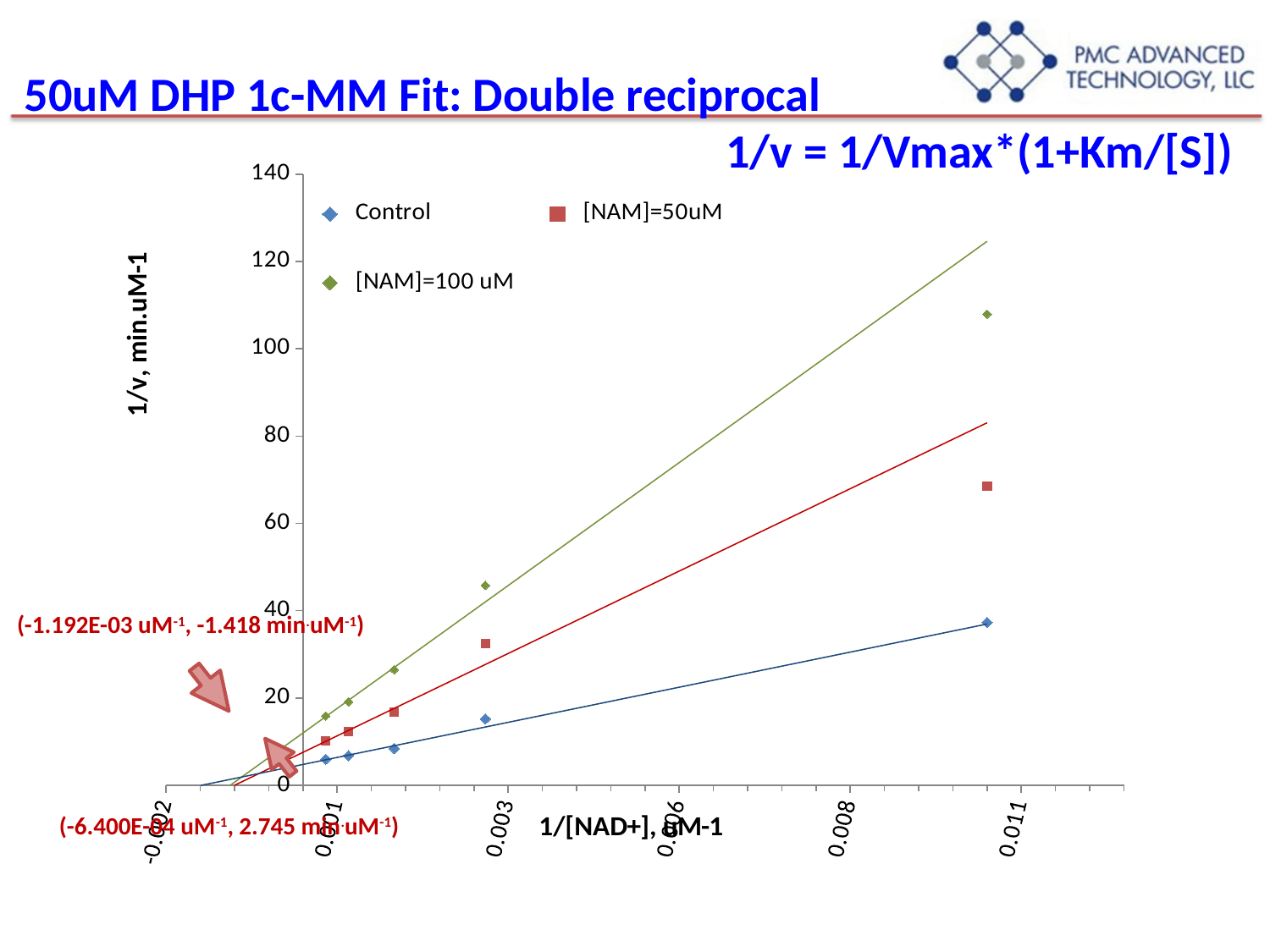
Which series has the lowest 1/v value at the largest 1/[NAD+] value (around 0.0105)? Control How many data points are plotted for the Control series? 5 What is the title of the y axis? 1/v, min.uM-1 At the rightmost data point, which series has the larger 1/v value, Control or [NAM]=50uM? [NAM]=50uM Is the 1/v value of the [NAM]=100 uM series at its rightmost point greater or less than 100? greater Is the 1/v value of the Control series at 1/[NAD+] of about 0.003 greater or less than 20? less Is the 1/v value of the [NAM]=50uM series at its rightmost point greater or less than 80? less What kind of chart is shown on the slide? scatter chart Which series has the highest 1/v value at the largest 1/[NAD+] value (around 0.0105)? [NAM]=100 uM Do the 1/v values rise or fall as 1/[NAD+] increases along the x axis? rise How many series does the legend list? 3